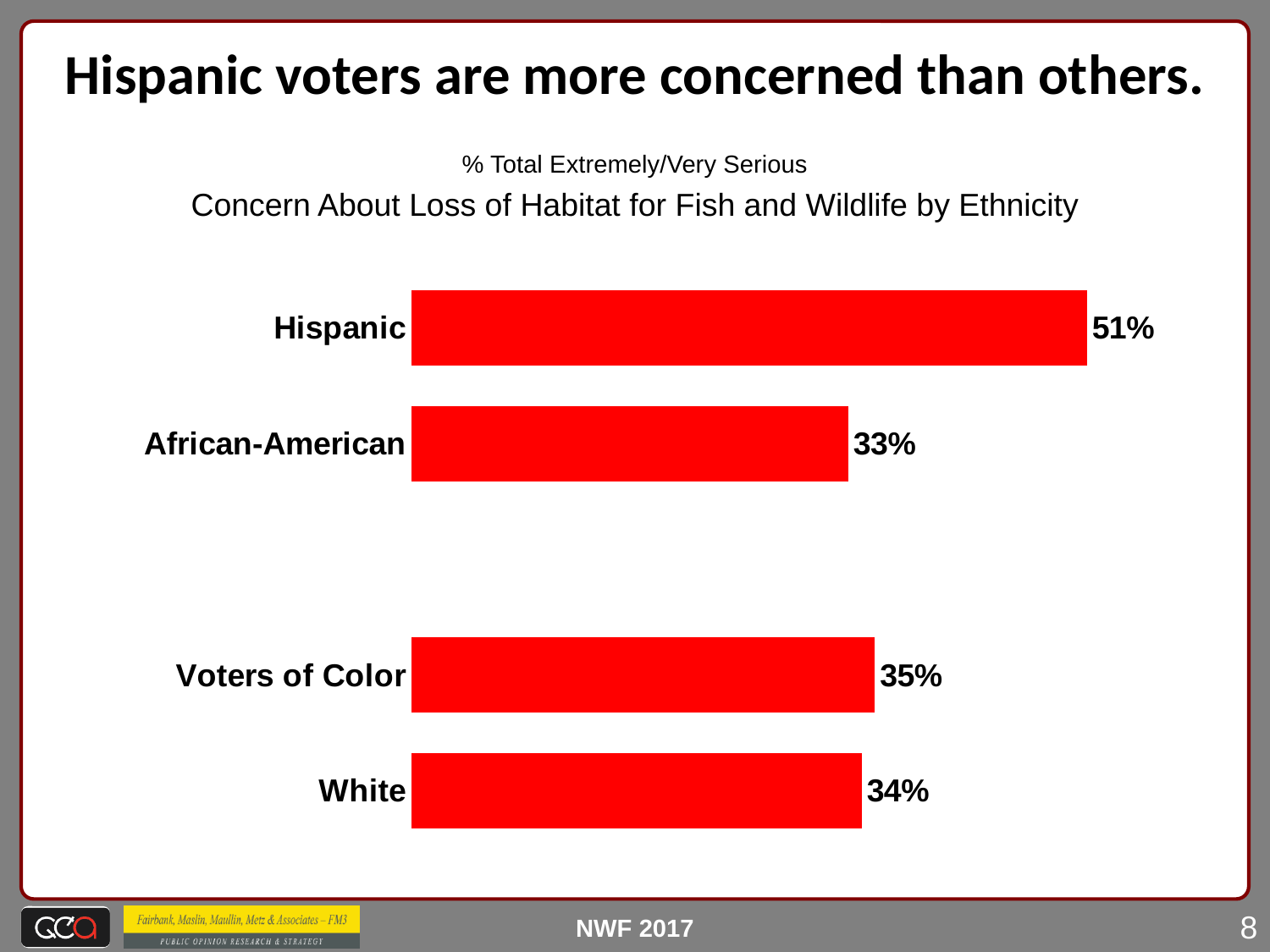
What kind of chart is shown on the slide? Bar chart How many ethnic groups are shown on the chart? 4 What is the difference between the Voters of Color value and the African-American value? 2% What colour are the bars on the chart? Red What is the value shown for Voters of Color? 35% What percentage of Hispanic voters rate concern about loss of habitat for fish and wildlife as extremely/very serious? 51% What is the value shown for White voters? 34% Which group has the lowest percentage shown on the chart? African-American What is the difference between the Hispanic value and the White value? 17% Which group has the highest percentage rating the concern as extremely/very serious? Hispanic What is the value shown for African-American voters? 33% Which is larger, the value for Hispanic voters or the value for African-American voters? Hispanic